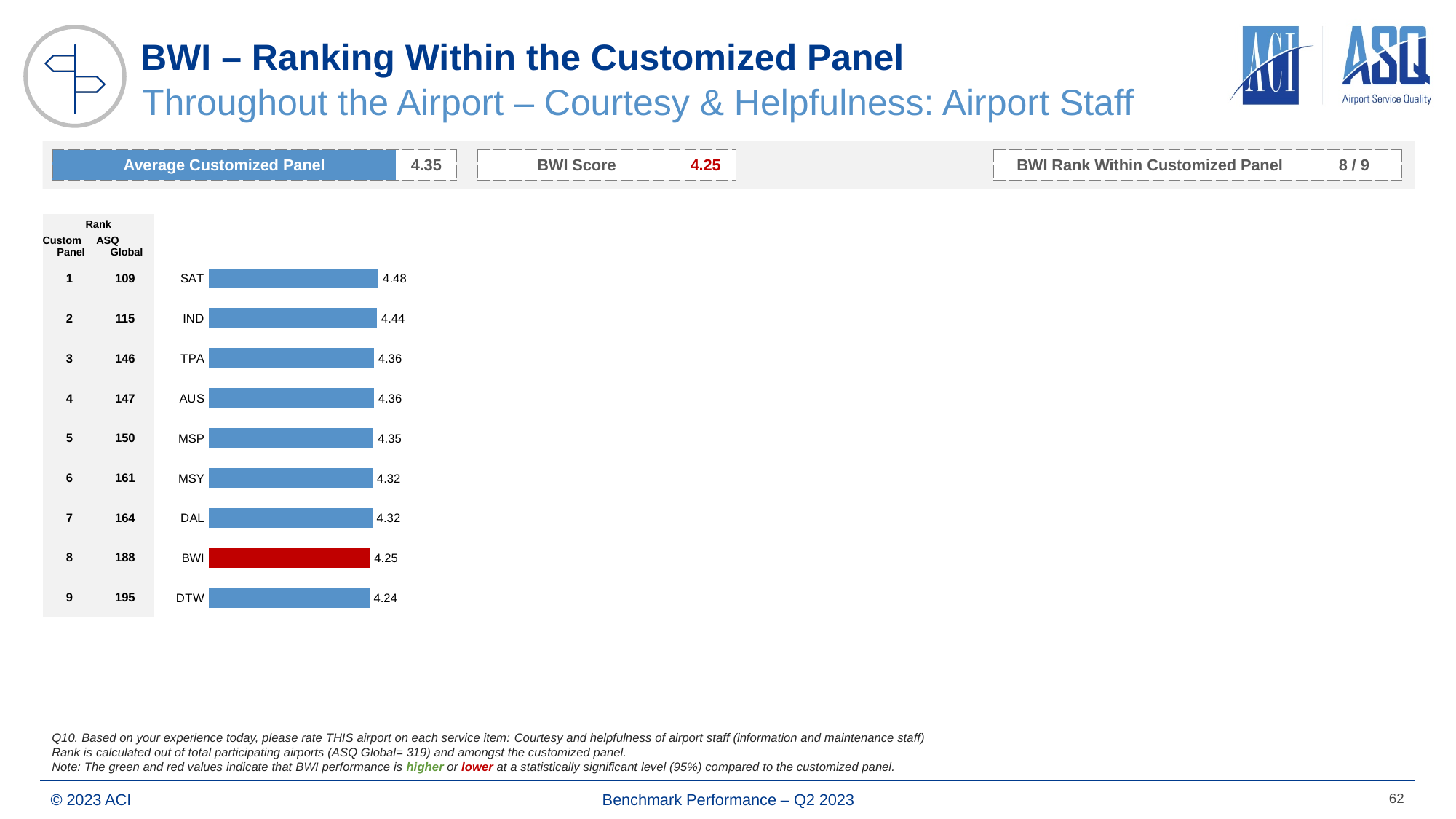
What is the value for DTW? 4.24 How many airports are shown in the chart? 9 Which airport has the highest value? SAT Which bar is coloured red? BWI What is the value for BWI? 4.25 What kind of chart is shown? Bar chart What is the difference between the values for SAT and BWI? 0.23 Which has a larger value, SAT or DAL? SAT Which airport has the lowest value? DTW What is the difference between the values for IND and DTW? 0.20 What is the value for SAT? 4.48 What is the value for MSP? 4.35